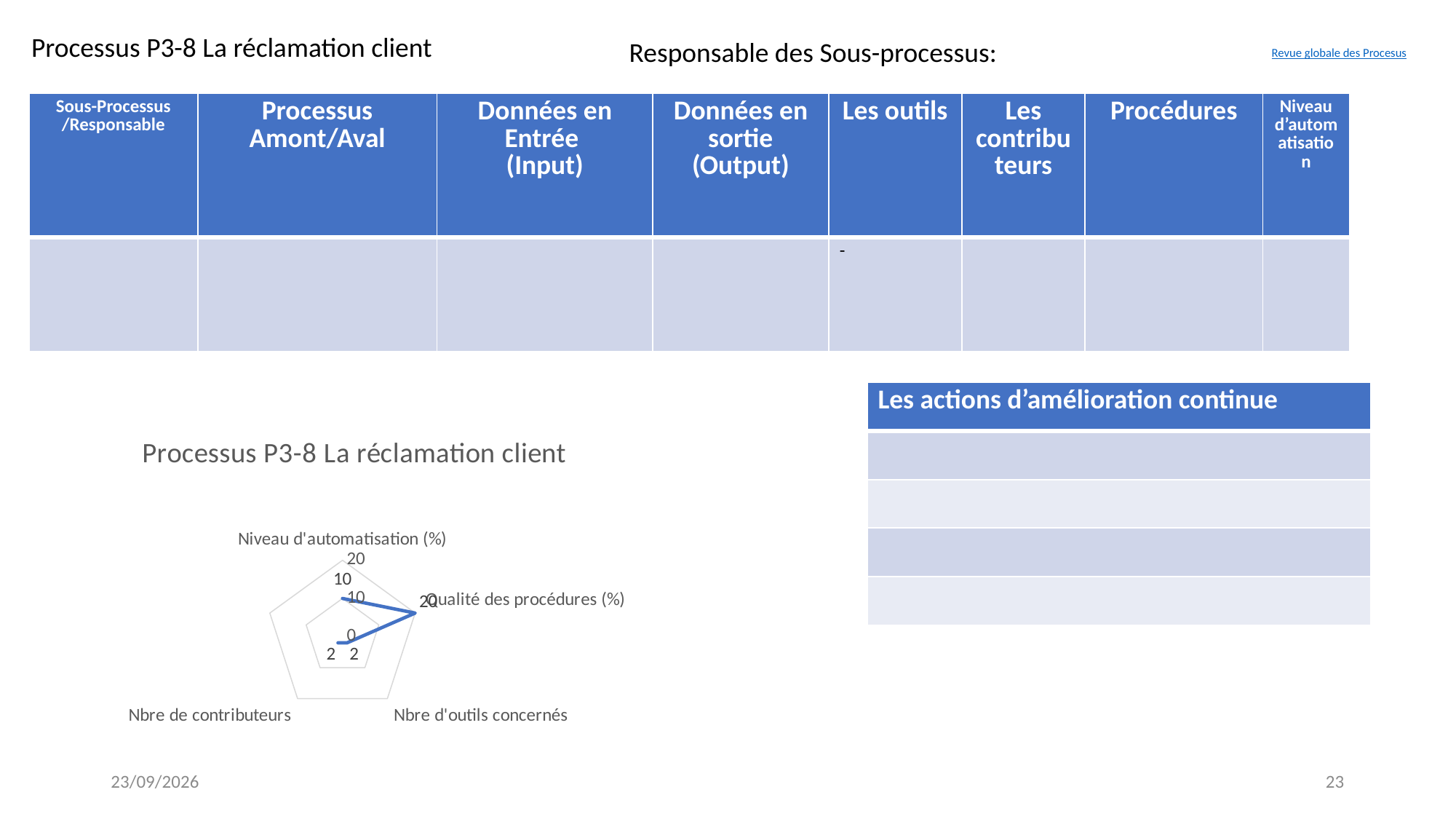
Which is larger, the value for Qualité des procédures (%) or the value for Nbre d'outils concernés? Qualité des procédures (%) What is the title of the chart? Processus P3-8 La réclamation client What is the value for Nbre de contributeurs in the chart? 2 What is the highest tick value shown on the chart's axis? 20 What is the difference between the values for Qualité des procédures (%) and Niveau d'automatisation (%)? 10 Is the value for Qualité des procédures (%) greater or less than 10? greater Which labelled category has the highest value in the chart? Qualité des procédures (%) What is the value for Niveau d'automatisation (%) in the chart? 10 What is the value for Qualité des procédures (%) in the chart? 20 What is the value for Nbre d'outils concernés in the chart? 2 What kind of chart is shown on the slide? radar chart